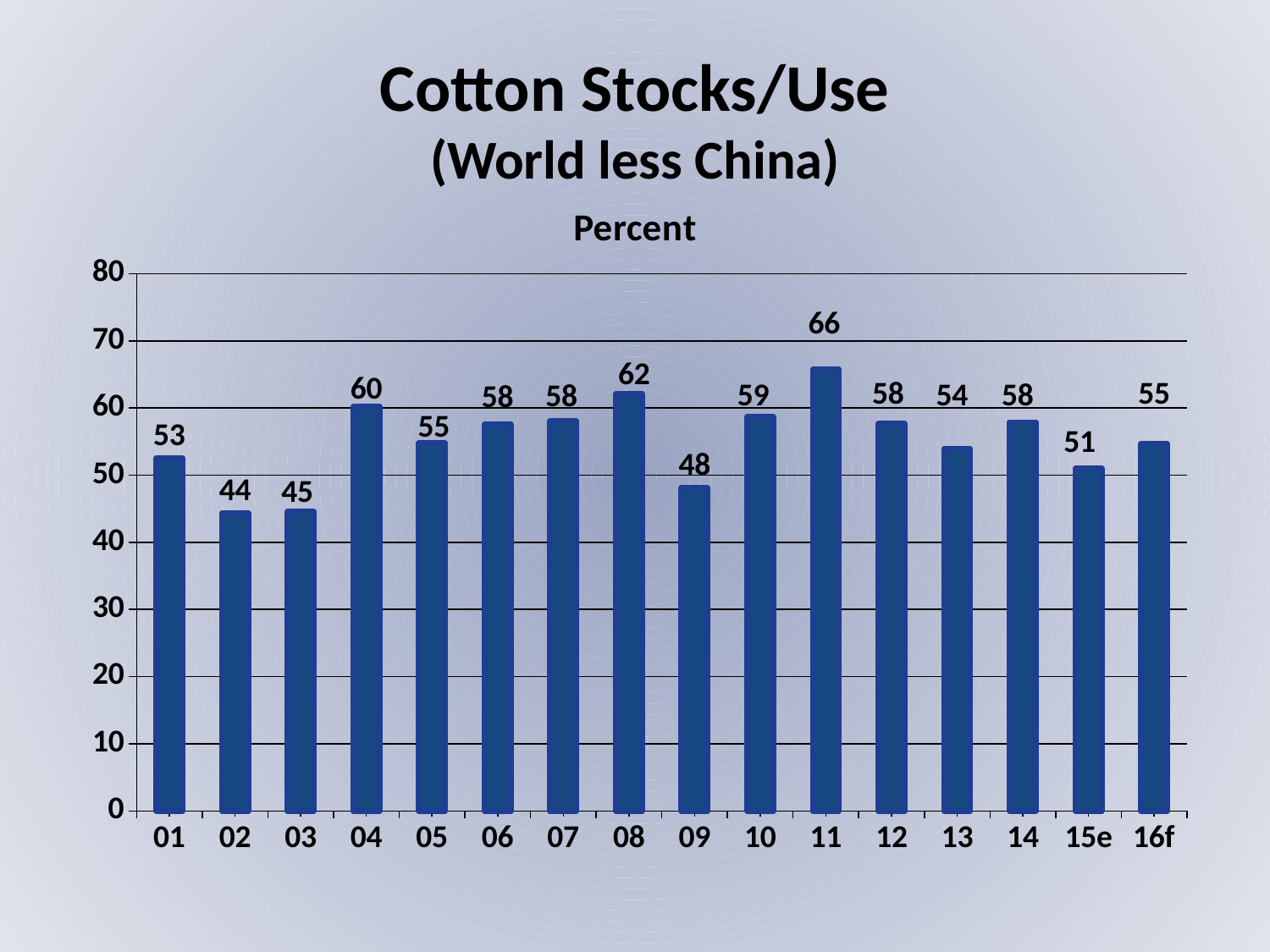
What is the difference between the values for 08 and 09? 14 What is the title of the chart? Percent Which category has the highest value? 11 What is the value for 04? 60 What is the value for 09? 48 Which is larger, the value for 10 or the value for 13? 10 What kind of chart is shown? bar chart What is the difference between the values for 11 and 02? 22 Which category has the lowest value? 02 What is the value for 15e? 51 Is the value for 11 greater or less than 60? greater How many categories are shown on the x axis? 16